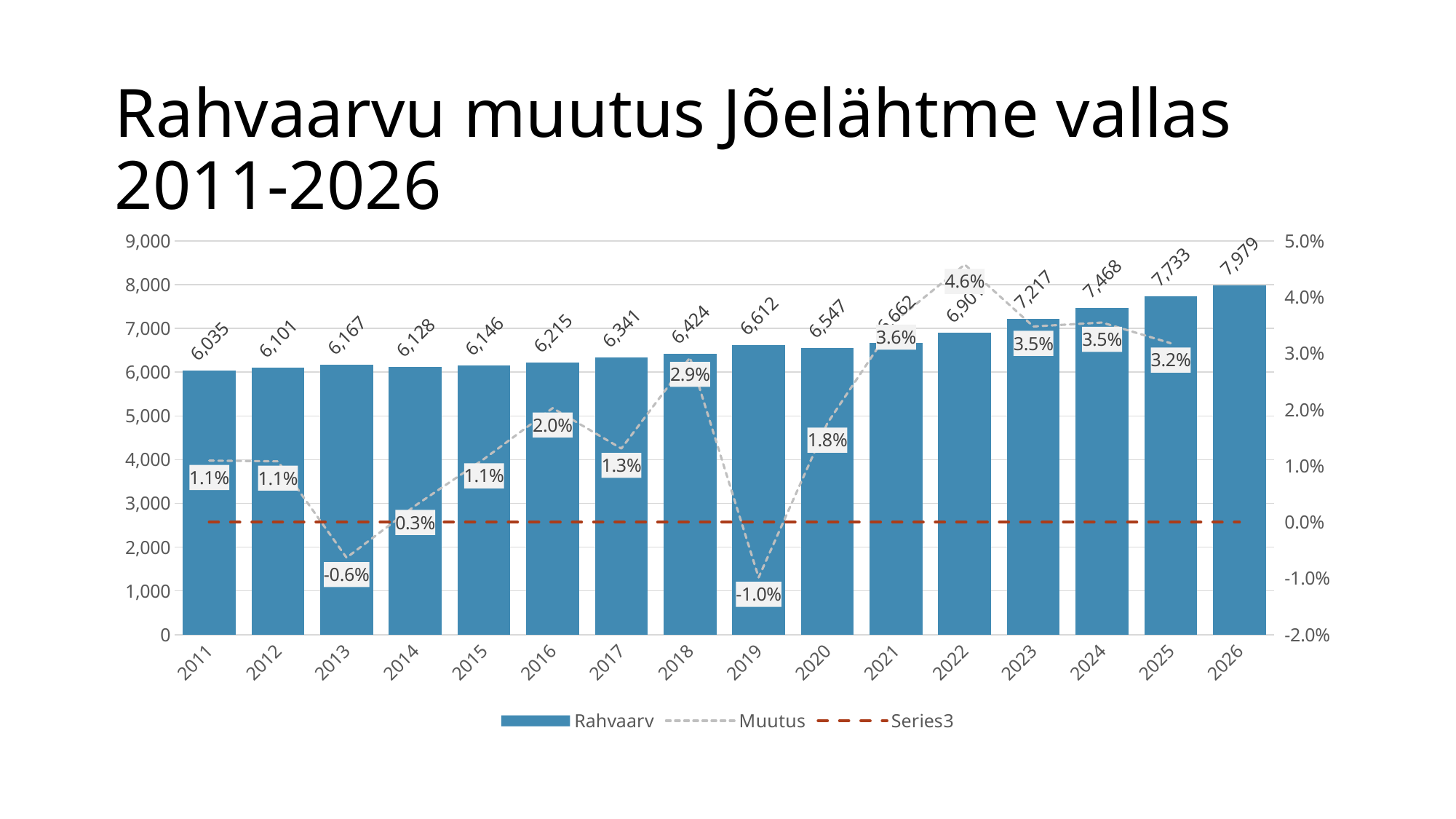
What is the Muutus value for 2022? 4.6% What is the Rahvaarv value for 2011? 6,035 Which is larger, the Rahvaarv value for 2019 or for 2020? 2019 How many series does the legend list? 3 What is the Muutus value for 2019? -1.0% Which year has the lowest Muutus value? 2019 What is the title of the chart? Rahvaarvu muutus Jõelähtme vallas 2011-2026 Which year has the highest Rahvaarv value? 2026 How many years are shown on the x axis? 16 Which year has the lowest Rahvaarv value? 2011 What is the Rahvaarv value for 2026? 7,979 What is the difference between the Rahvaarv values for 2026 and 2025? 246